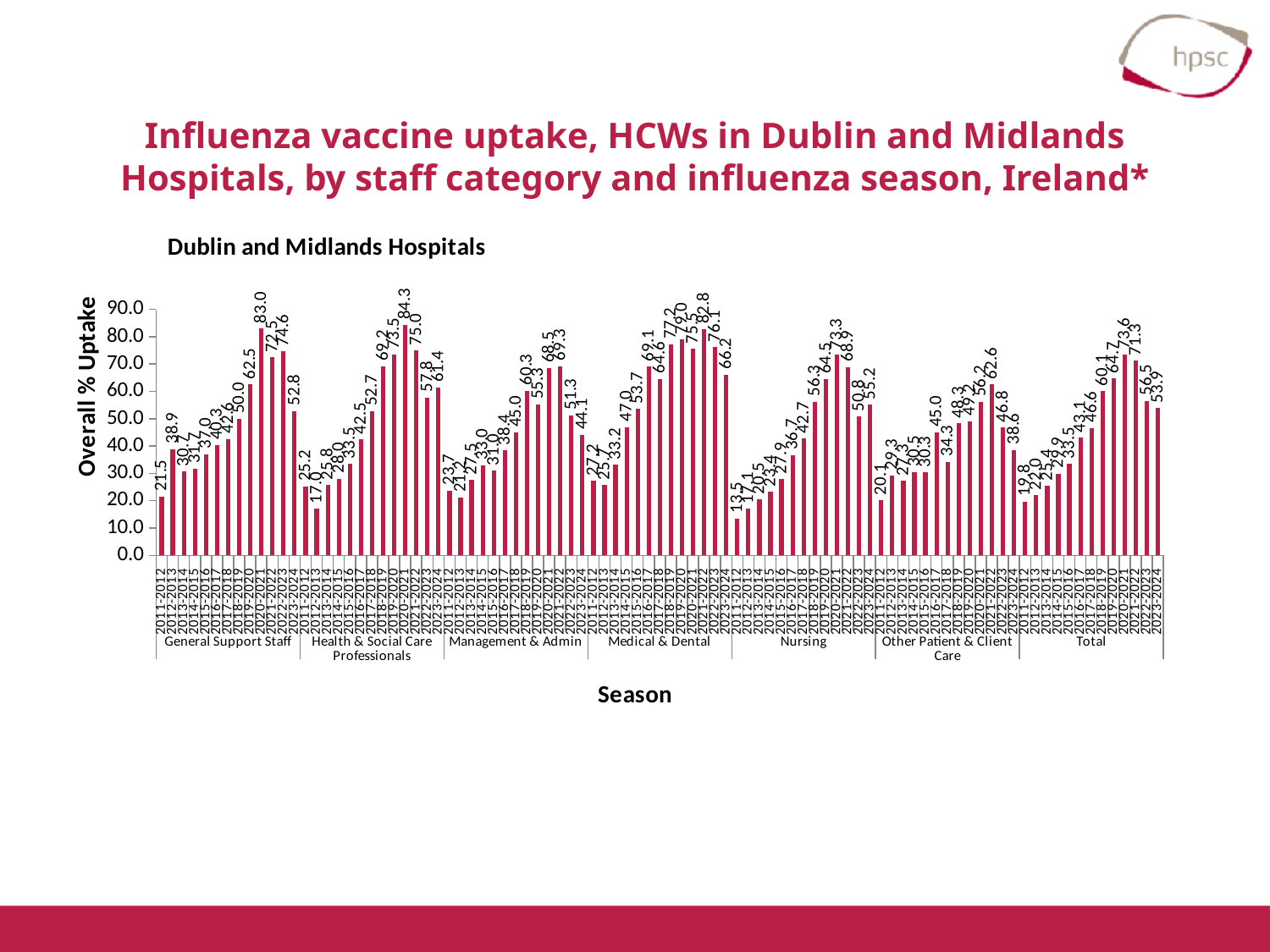
What type of chart is used on this slide? Bar chart What is the difference between the Total uptake in 2020-2021 and in 2023-2024? 19.7 Which staff category and season has the lowest overall % uptake on the chart? Nursing, 2011-2012 (13.5) Which is larger: the Medical & Dental uptake in 2021-2022 or the General Support Staff uptake in 2020-2021? General Support Staff 2020-2021 (83.0) What is the overall % uptake for the Total category in the 2023-2024 season? 53.9 How many staff category groups are shown along the x axis? 7 How many influenza seasons are shown for each staff category? 13 What is the overall % uptake for Nursing in the 2011-2012 season? 13.5 Which staff category and season has the highest overall % uptake on the chart? Health & Social Care Professionals, 2020-2021 (84.3) Is the Nursing uptake for 2019-2020 greater or less than 60.0? greater What is the overall % uptake for General Support Staff in the 2020-2021 season? 83.0 What is the label on the y axis of the chart? Overall % Uptake